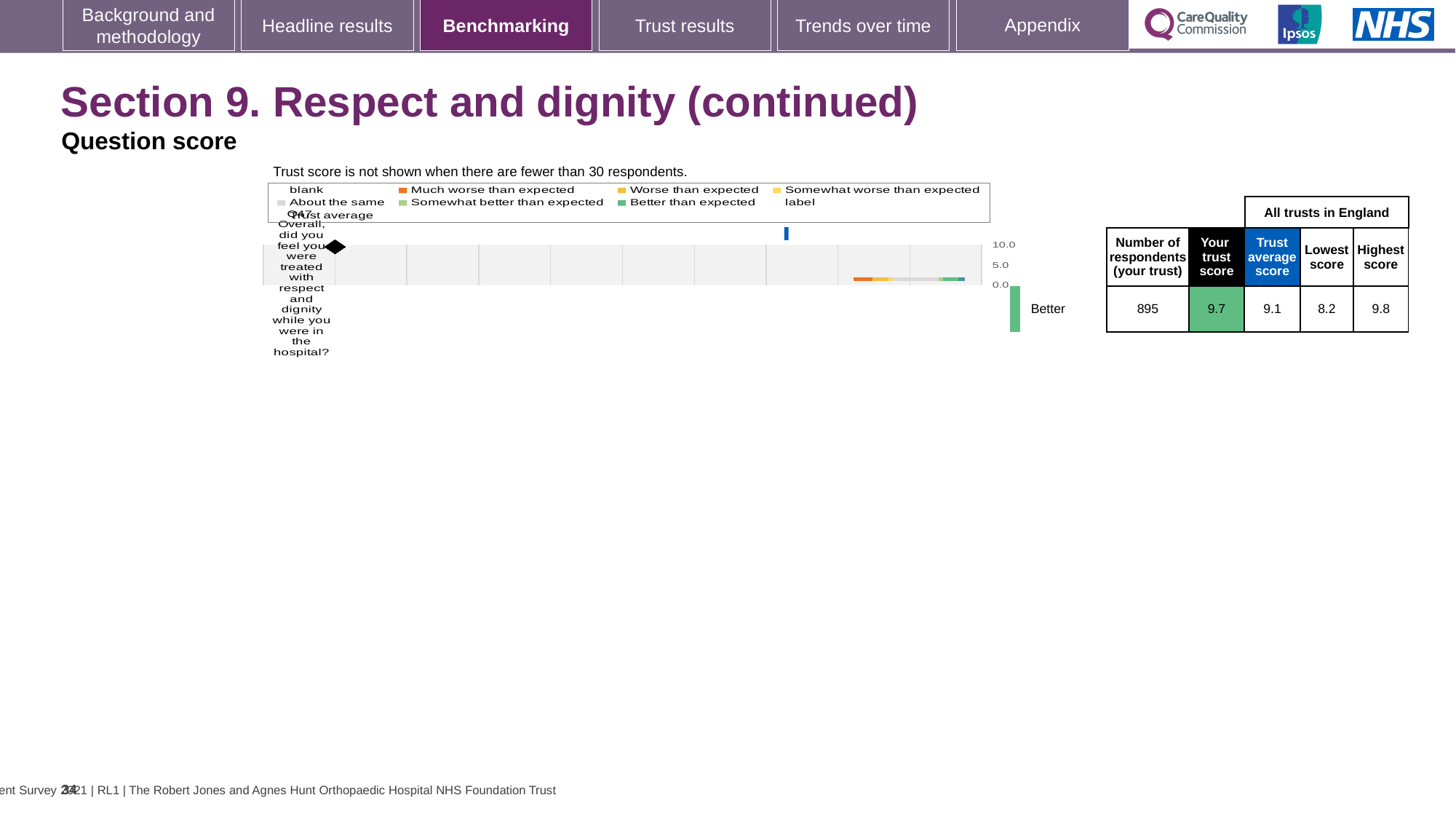
Is the trust score for the respect and dignity question greater or less than 5.0? greater What is the difference between the highest score (9.8) and the lowest score (8.2) in the table? 1.6 What is the highest tick value shown on the chart's score axis? 10.0 What is the difference between your trust score (9.7) and the trust average score (9.1)? 0.6 Which is larger: your trust score (9.7) or the trust average score (9.1)? Your trust score How many questions (categories) are plotted in the chart? 1 What colour is used for the "Much worse than expected" legend entry? Orange What is the trust score shown for the question "Overall, did you feel you were treated with respect and dignity while you were in the hospital?"? 9.7 According to the table next to the chart, how many respondents did your trust have for this question? 895 What kind of chart is shown on the slide? Bar chart According to the table next to the chart, what is the trust average score for all trusts in England? 9.1 Which category does the green "Better" marker beside the chart indicate for your trust's result? Better